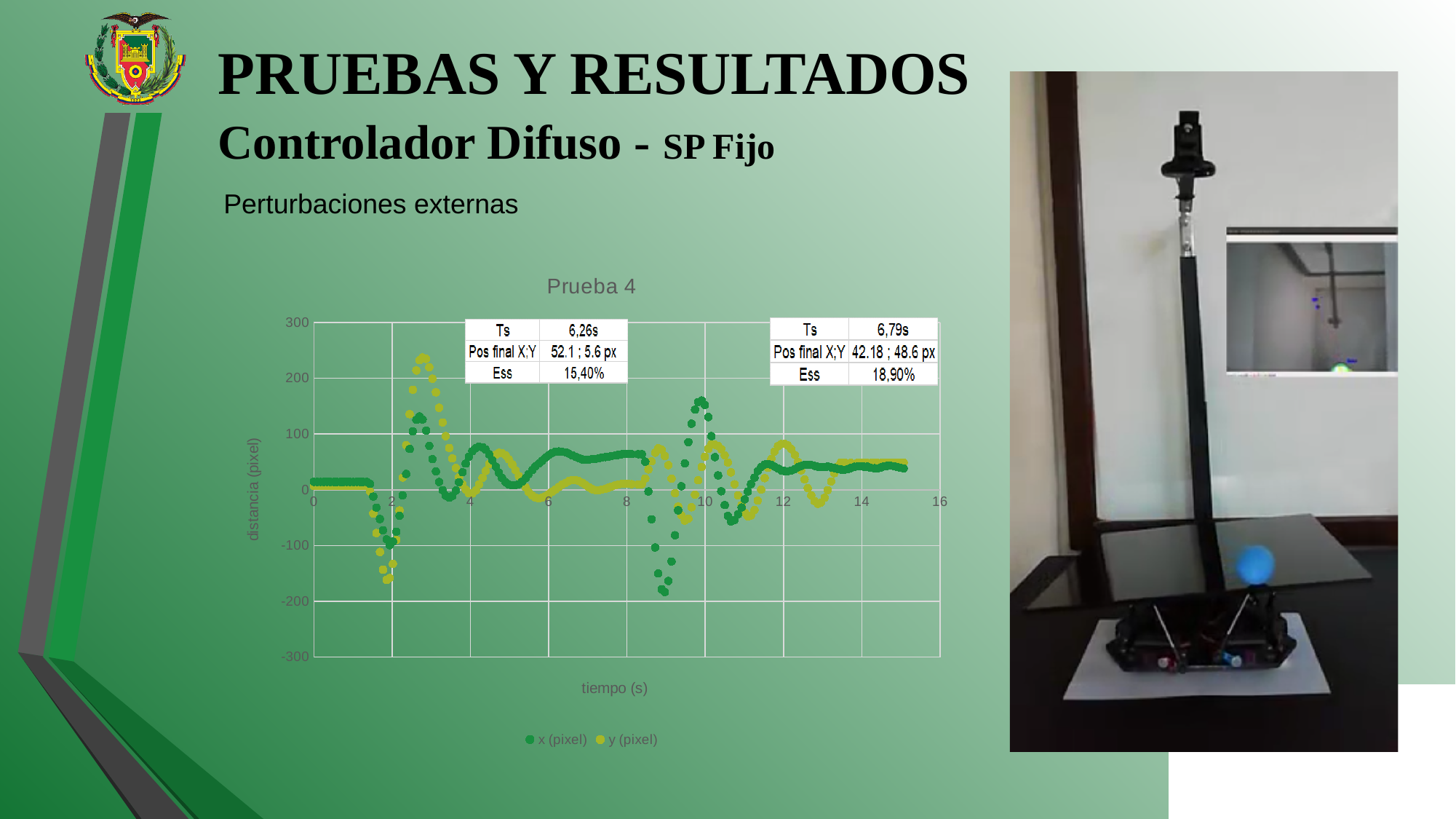
In the left table on the chart, what is the value of Ess? 15,40% In the right table on the chart, what is the value of Ess? 18,90% What is the title of the chart on the slide? Prueba 4 Is the highest value reached by the y (pixel) series around 3 s greater or less than 200? greater What kind of chart is shown on the slide? scatter chart In the right table on the chart, what is the value of Ts? 6,79s How many series does the chart legend list? 2 Is the lowest value reached by the x (pixel) series around 9 s greater or less than -100? less What are the two series named in the chart legend? x (pixel) and y (pixel) What is the label of the horizontal axis of the chart? tiempo (s) In the right table on the chart, what is the value of Pos final X;Y? 42.18 ; 48.6 px In the left table on the chart, what is the value of Ts? 6,26s